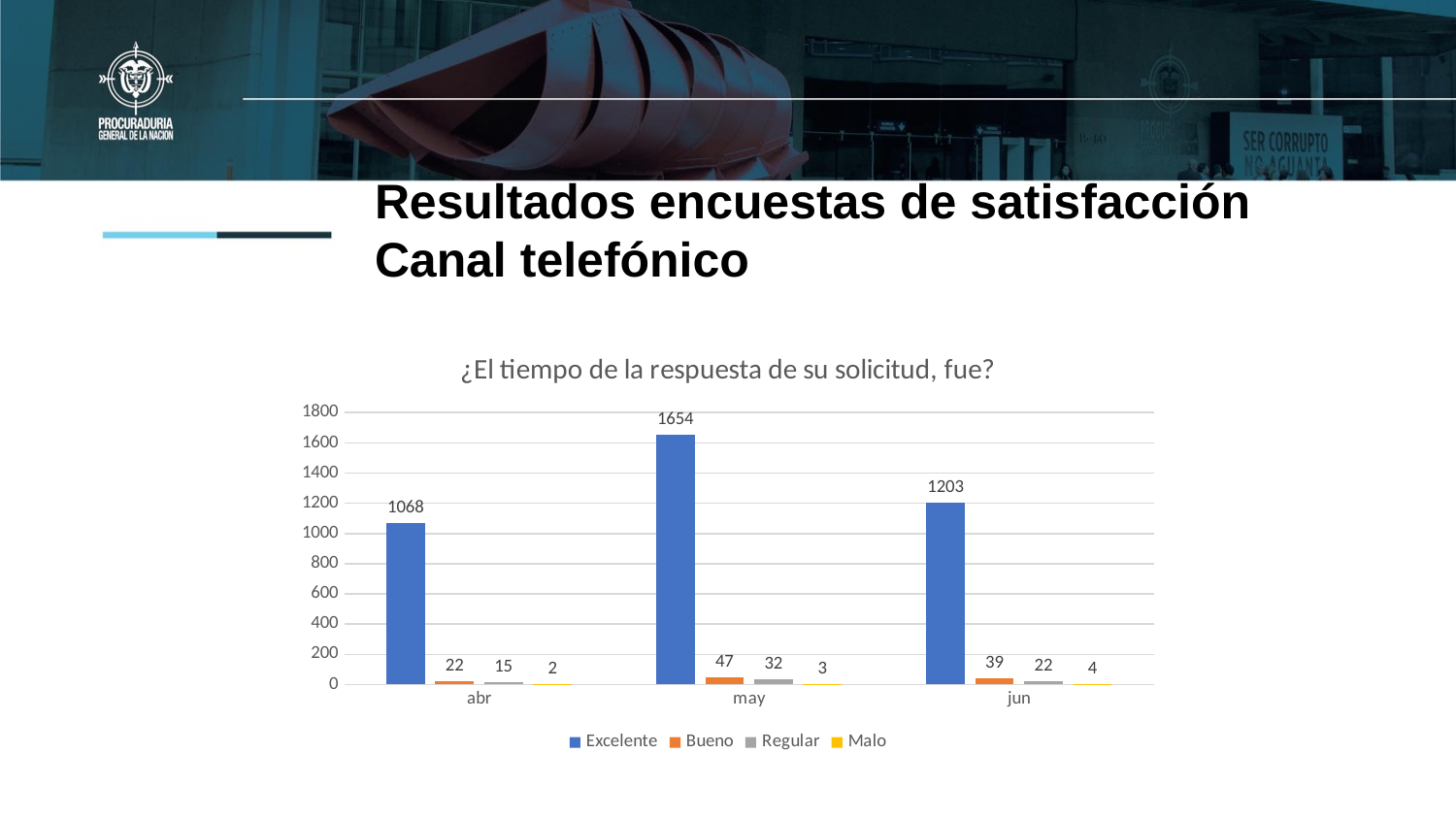
How many months are shown on the x axis? 3 What is the value for Bueno in jun? 39 How many series does the legend list? 4 What is the value for Malo in may? 3 Which month has the lowest value for Malo? abr What is the value for Regular in abr? 15 What is the value for Excelente in may? 1654 Is the value for Excelente in jun greater or less than 1000? greater What kind of chart is shown on the slide? bar chart Which month has the highest value for Excelente? may What is the difference between the Excelente values for may and abr? 586 Which is larger, the Bueno value for may or the Bueno value for jun? may